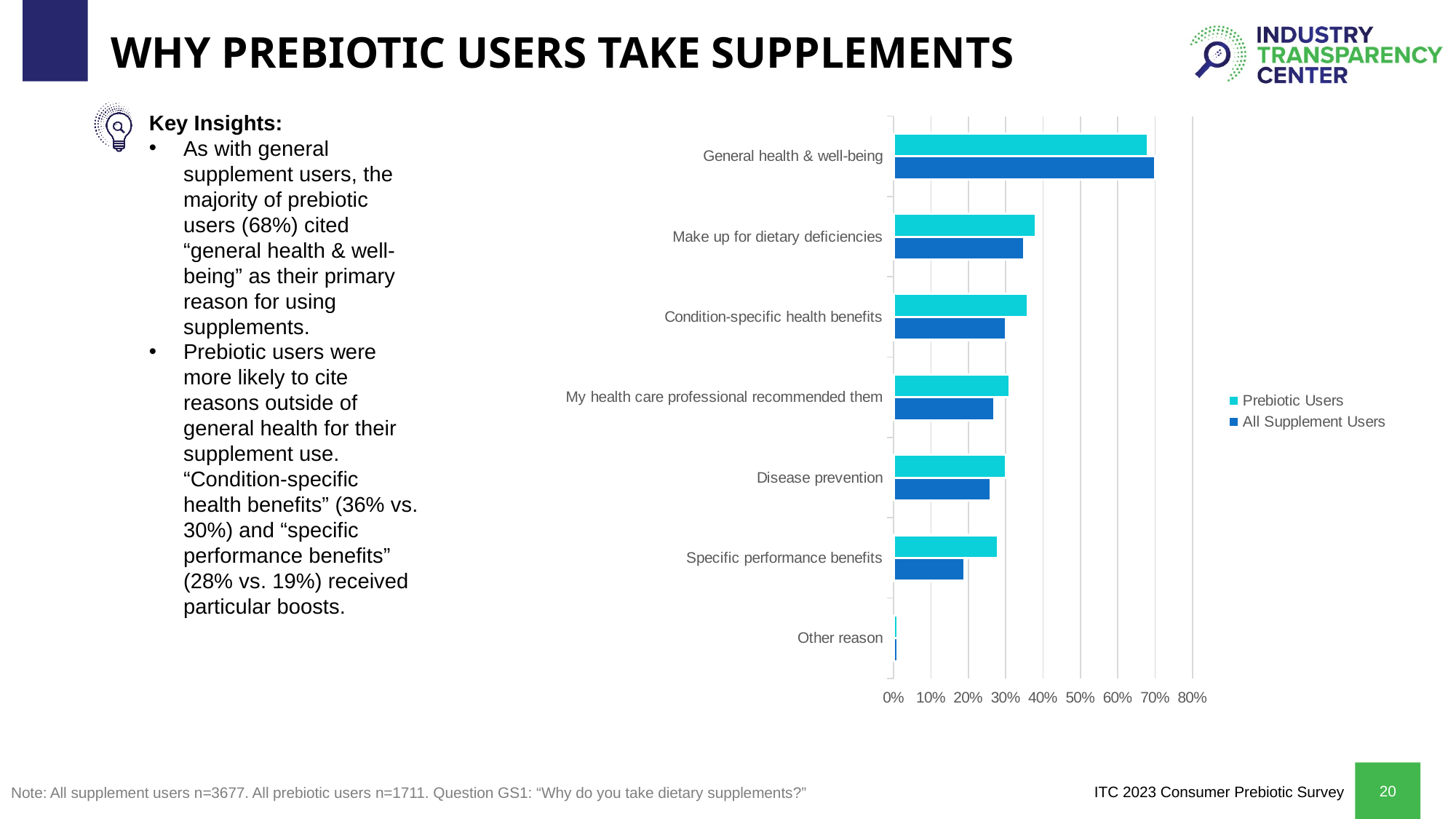
Is the All Supplement Users value for Disease prevention greater or less than 30%? less Is the Prebiotic Users value for General health & well-being greater or less than 60%? greater Which series is shown in the darker blue bars according to the legend? All Supplement Users For Condition-specific health benefits, which series has the larger value: Prebiotic Users or All Supplement Users? Prebiotic Users How many reasons (categories) are listed on the chart? 7 Is the Prebiotic Users value for Other reason greater or less than 10%? less Which reason has the lowest value for All Supplement Users? Other reason For Specific performance benefits, which series has the larger value: Prebiotic Users or All Supplement Users? Prebiotic Users How many series does the chart legend list? 2 Which reason has the highest value for Prebiotic Users? General health & well-being What kind of chart is shown on the slide? bar chart